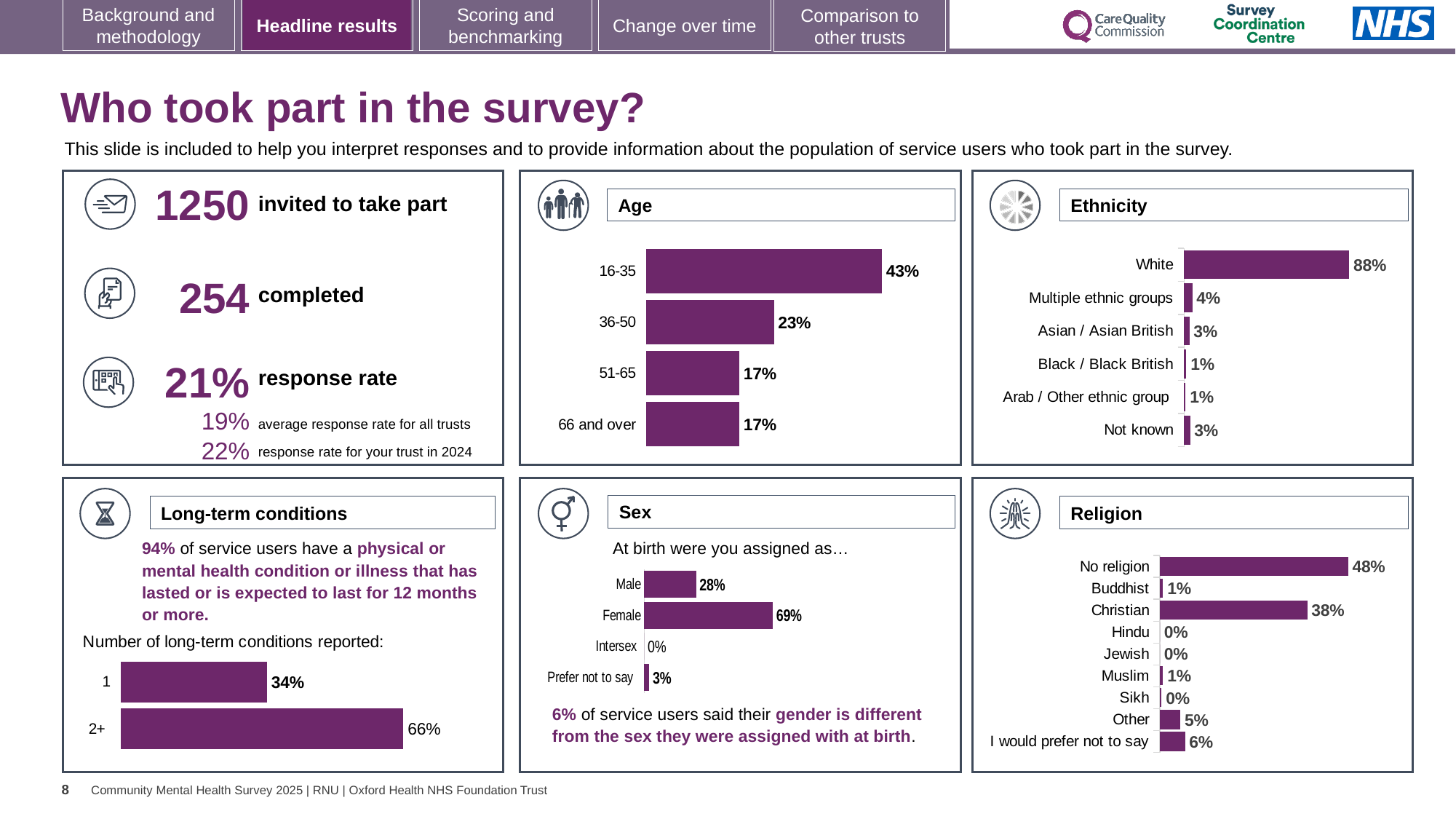
In the Ethnicity chart, which is larger: Multiple ethnic groups or Asian / Asian British? Multiple ethnic groups In the Religion chart, which category has the highest percentage? No religion In the Long-term conditions chart, what percentage of respondents reported 2+ long-term conditions? 66% In the Sex chart, what is the difference between the Female and Male percentages? 41% In the Age chart, which age group has the highest percentage? 16-35 In the Ethnicity chart, what percentage of respondents were White? 88% In the Religion chart, what percentage of respondents were Christian? 38% In the Age chart, what percentage of respondents were aged 16-35? 43% In the Sex chart, what percentage of respondents were assigned Female at birth? 69% In the Ethnicity chart, how many ethnicity categories are shown? 6 What kind of chart is used in the Age panel? Bar chart In the Age chart, what is the difference between the 16-35 and 36-50 percentages? 20%